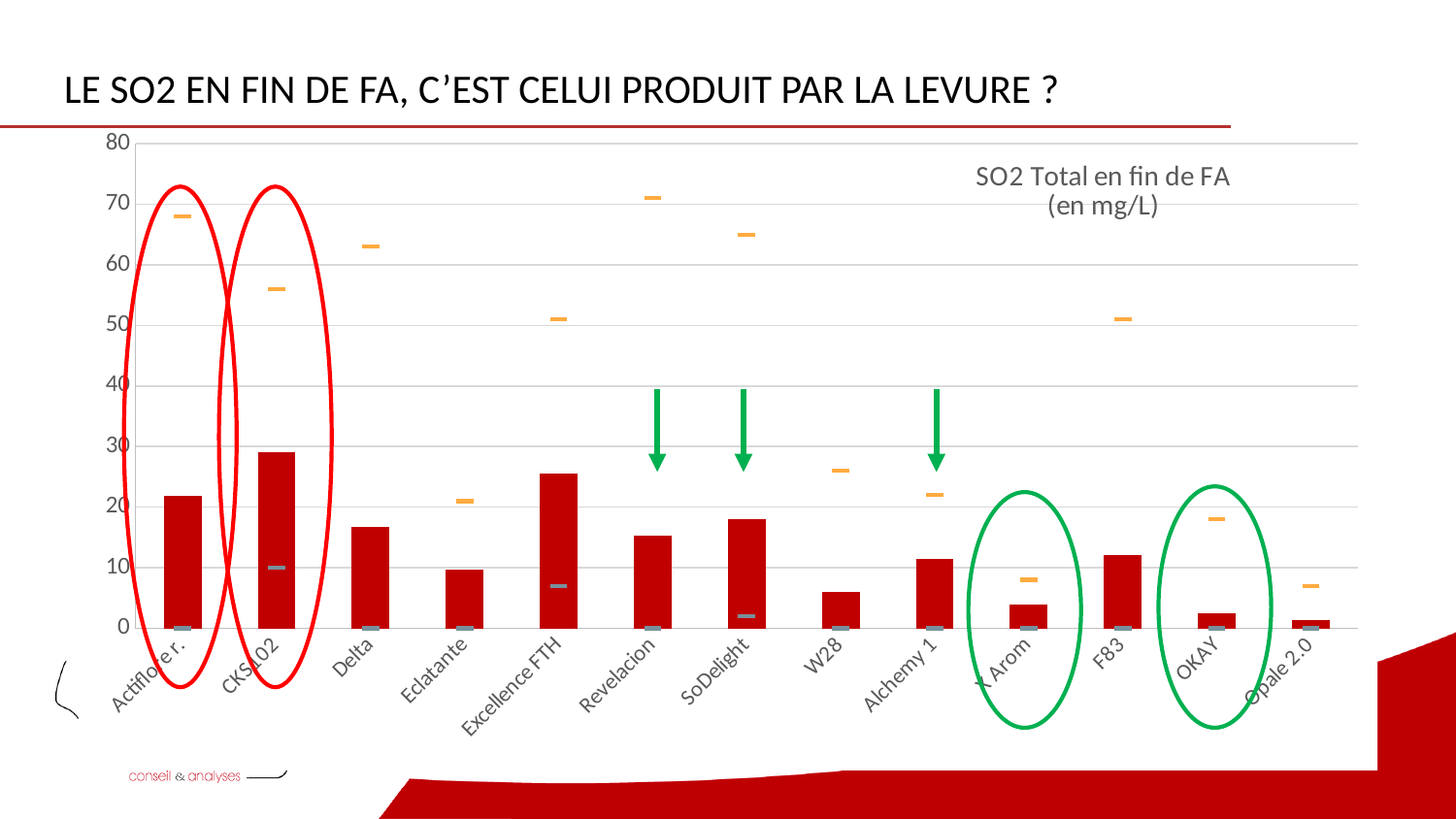
Is the orange marker (SO2 Total en fin de FA) for Delta greater or less than 60? greater What unit is given in the chart's text label 'SO2 Total en fin de FA'? mg/L Is the orange marker (SO2 Total en fin de FA) for X Arom greater or less than 10? less Which category has the tallest red bar? CKS102 Which category has the highest orange marker for SO2 Total en fin de FA? Revelacion How many yeast strains (categories) are shown along the x axis? 13 What kind of chart is shown on the slide? bar chart Which category has the shortest red bar? Opale 2.0 Is the red bar for Actiflore r. greater or less than 20? greater Which has the larger red bar, Delta or Eclatante? Delta